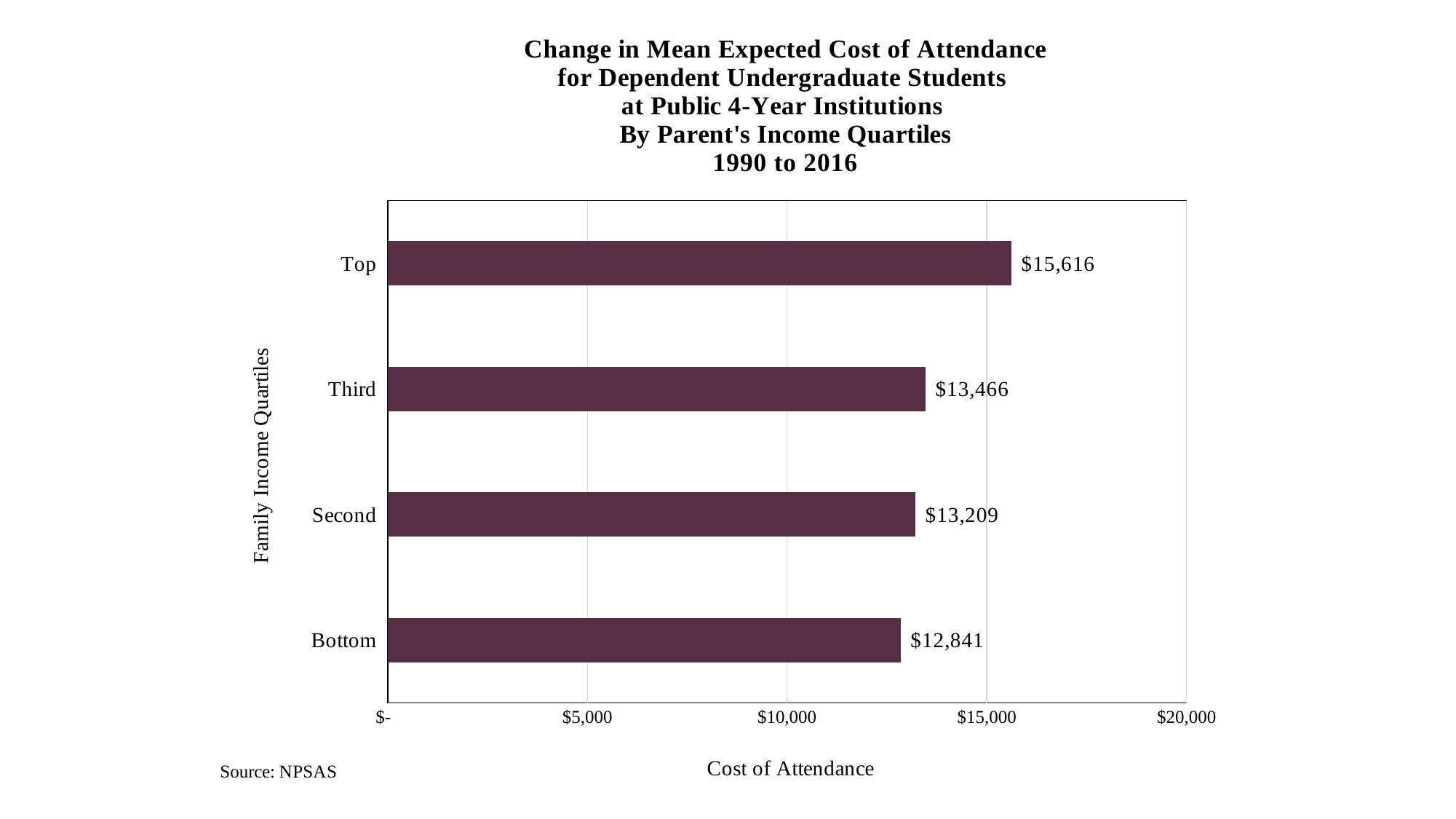
What is the value for the Top income quartile? $15,616 What is the difference between the values for the Top and Bottom quartiles? $2,775 Which income quartile has the highest change in mean expected cost of attendance? Top Which is larger, the value for the Third quartile or the Second quartile? Third Which income quartile has the lowest change in mean expected cost of attendance? Bottom What kind of chart is shown on the slide? Bar chart What is the source cited for the chart? NPSAS What is the difference between the values for the Third and Second quartiles? $257 Is the value for the Top quartile greater or less than $15,000? greater How many income quartiles are shown in the chart? 4 What is the value for the Bottom income quartile? $12,841 What is the value for the Second income quartile? $13,209